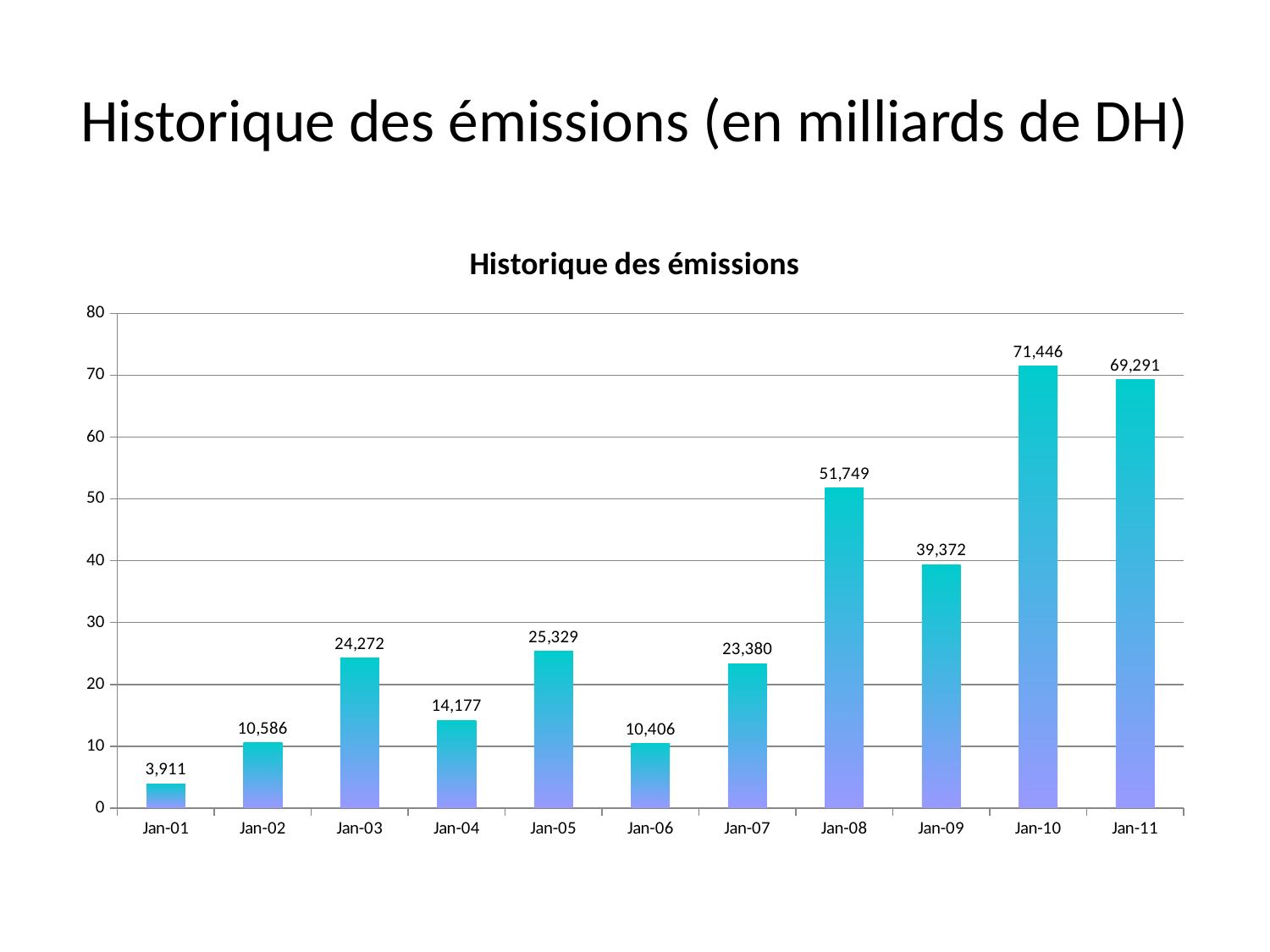
What is the value for Jan-05? 25,329 What kind of chart is shown on the slide? bar chart What is the value for Jan-01? 3,911 How many years are shown on the x axis? 11 What is the difference between the values for Jan-08 and Jan-09? 12,377 What is the difference between the values for Jan-10 and Jan-11? 2,155 Which is larger, the value for Jan-03 or the value for Jan-07? Jan-03 Which year has the lowest value? Jan-01 Is the value for Jan-09 greater or less than 40? less What is the title of the chart? Historique des émissions What is the value for Jan-08? 51,749 Which year has the highest value? Jan-10